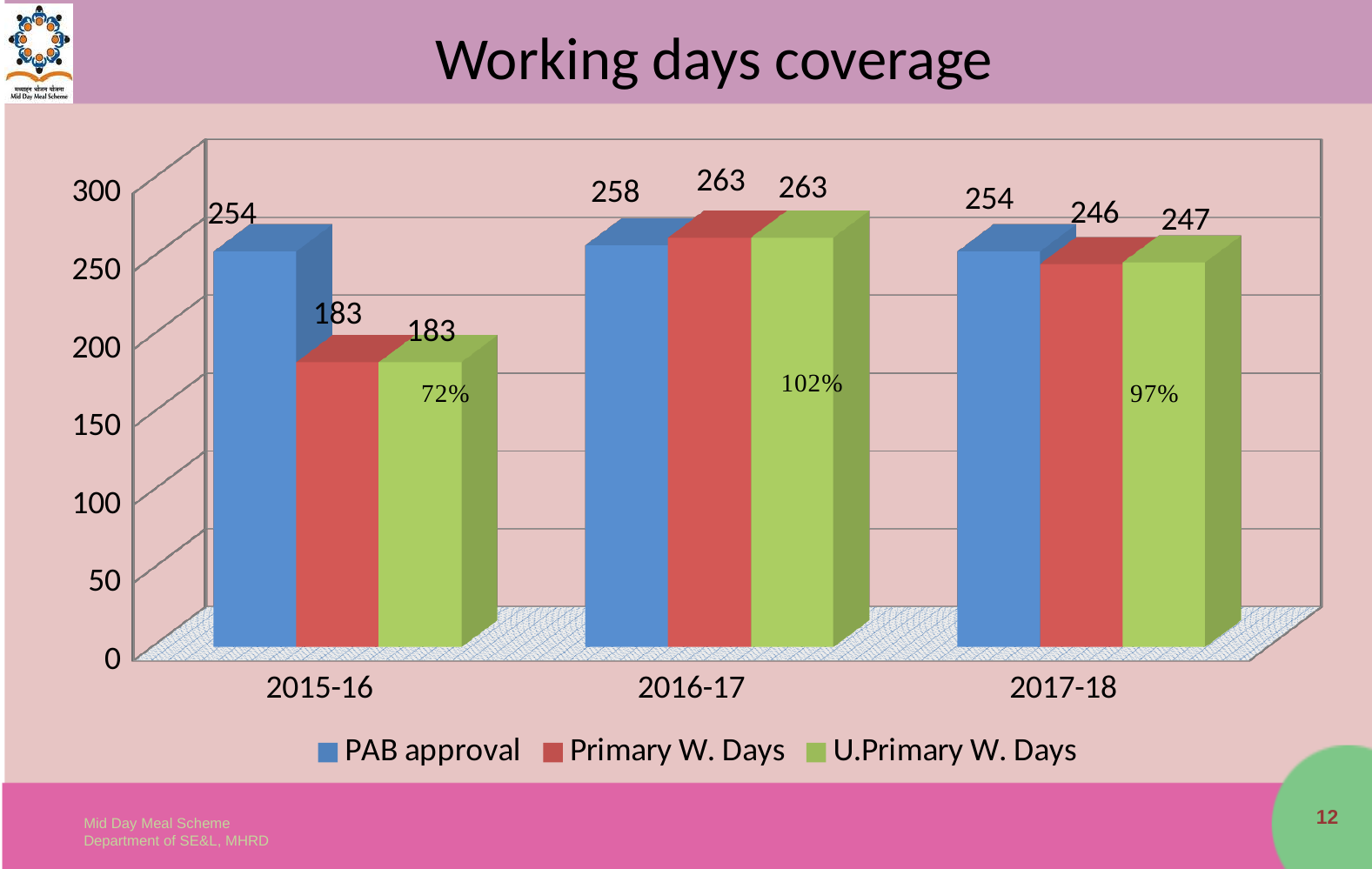
How many series does the legend list? 3 What is the difference between PAB approval and Primary W. Days in 2015-16? 71 Which year has the lowest U.Primary W. Days value? 2015-16 What is the PAB approval value for 2015-16? 254 What is the U.Primary W. Days value for 2017-18? 247 How many year categories are shown on the x axis? 3 What kind of chart is shown on the slide? Bar chart Which year has the highest Primary W. Days value? 2016-17 What is the title of the chart? Working days coverage Is the PAB approval value larger than the Primary W. Days value in 2017-18? Yes, PAB approval (254) is larger than Primary W. Days (246) What is the Primary W. Days value for 2016-17? 263 What percentage label is shown for 2016-17? 102%